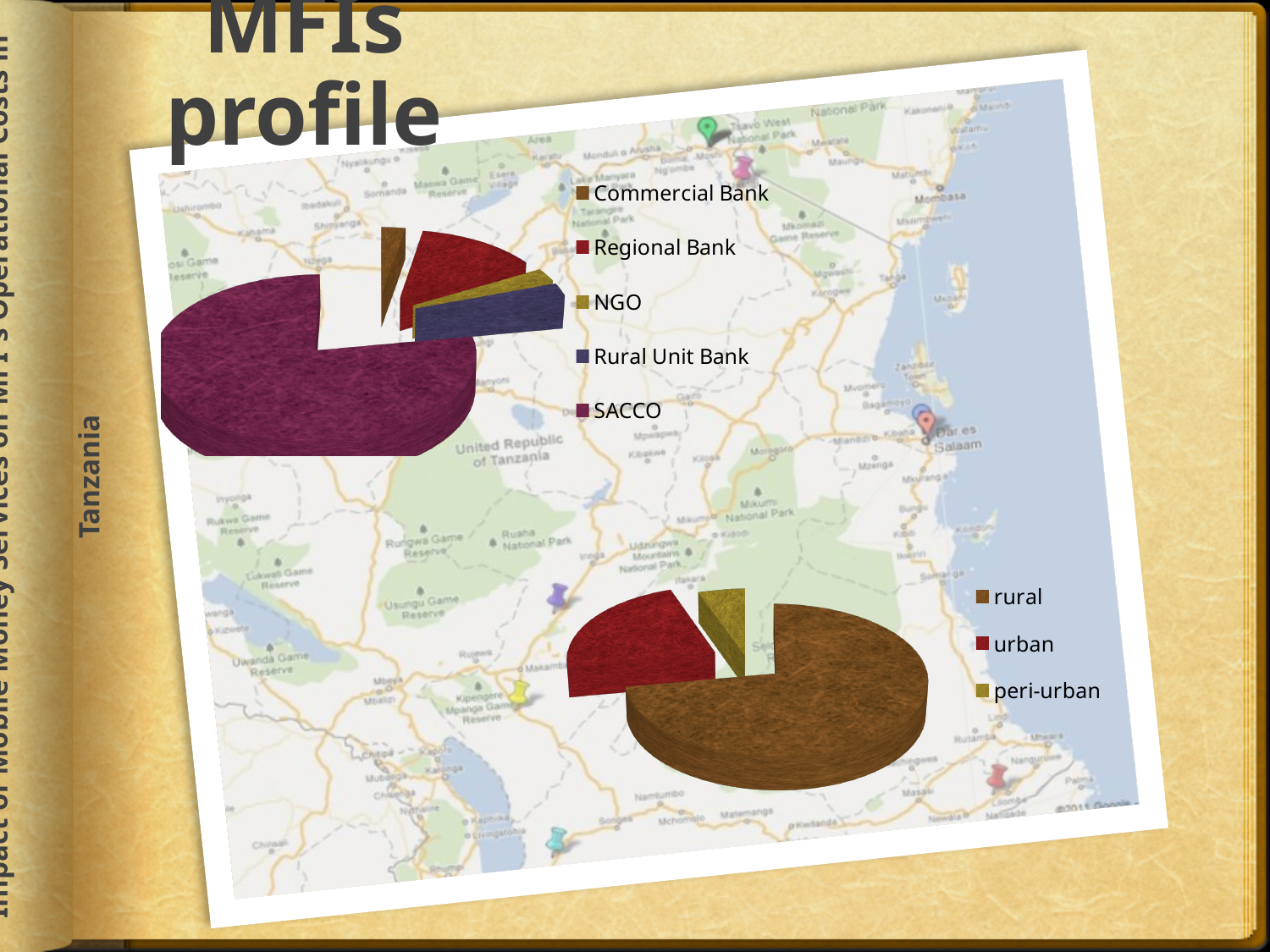
In the top pie chart, which category has the largest slice? SACCO What kind of chart is the top chart on the slide? pie chart What kind of chart is the bottom chart on the slide? pie chart In the bottom pie chart, which slice is larger: urban or peri-urban? urban In the bottom pie chart, how many categories does the legend list? 3 In the top pie chart, what colour is the SACCO slice? purple In the bottom pie chart, which category has the largest slice? rural In the top pie chart, which slice is larger: Regional Bank or Commercial Bank? Regional Bank In the bottom pie chart, what colour is the rural slice? brown In the bottom pie chart, which category has the smallest slice? peri-urban In the top pie chart, how many categories does the legend list? 5